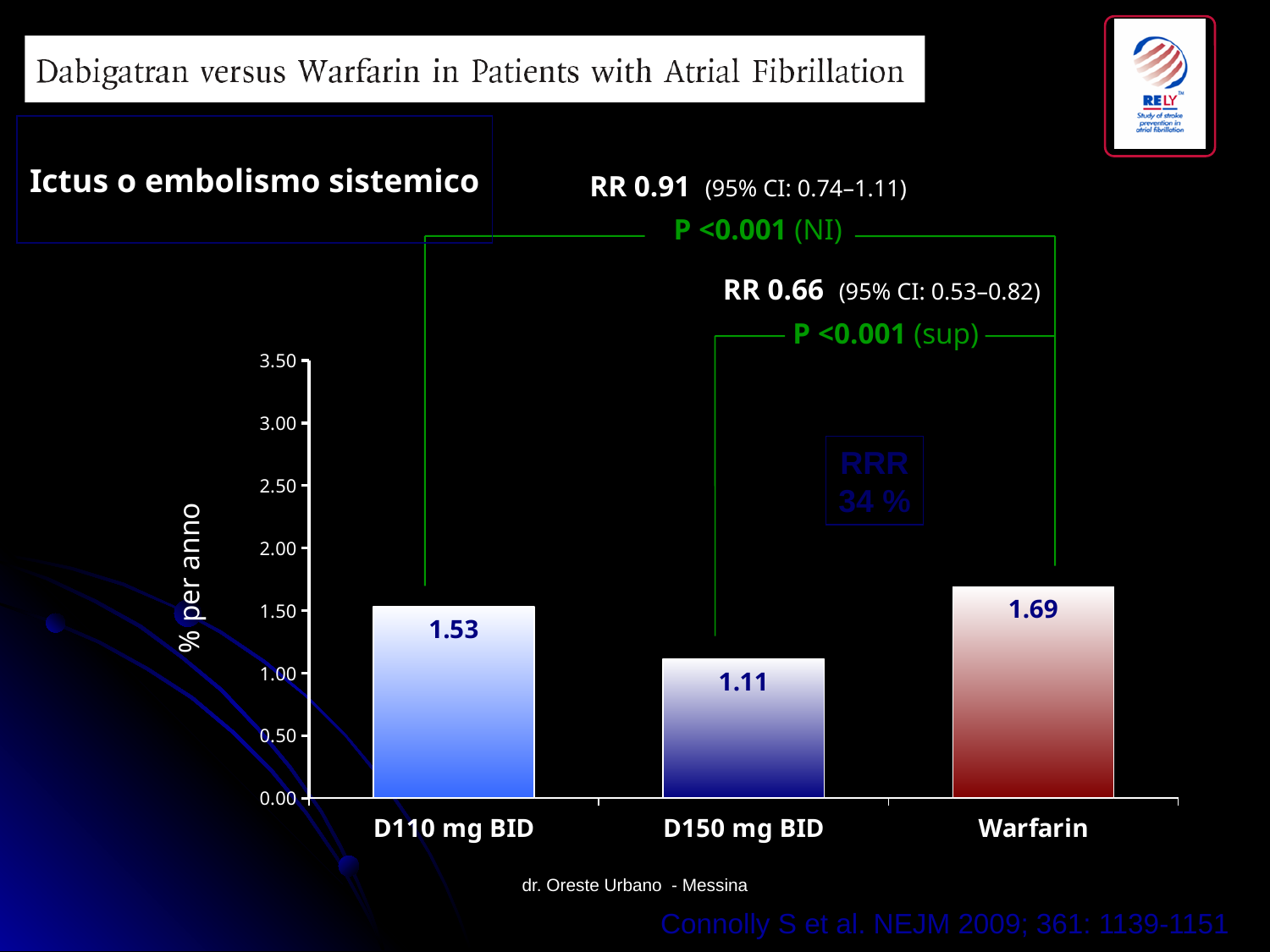
Which category has the lowest value? D150 mg BID Is the value for Warfarin greater or less than 2.00? less What is the value for D110 mg BID? 1.53 How many categories are shown on the x axis? 3 What is the value for D150 mg BID? 1.11 Which is larger, the value for D110 mg BID or the value for D150 mg BID? D110 mg BID What is the difference between the values for Warfarin and D150 mg BID? 0.58 What is the difference between the values for Warfarin and D110 mg BID? 0.16 What is the value for Warfarin? 1.69 What kind of chart is shown on the slide? bar chart Which category has the highest value? Warfarin What is the label of the y axis? % per anno